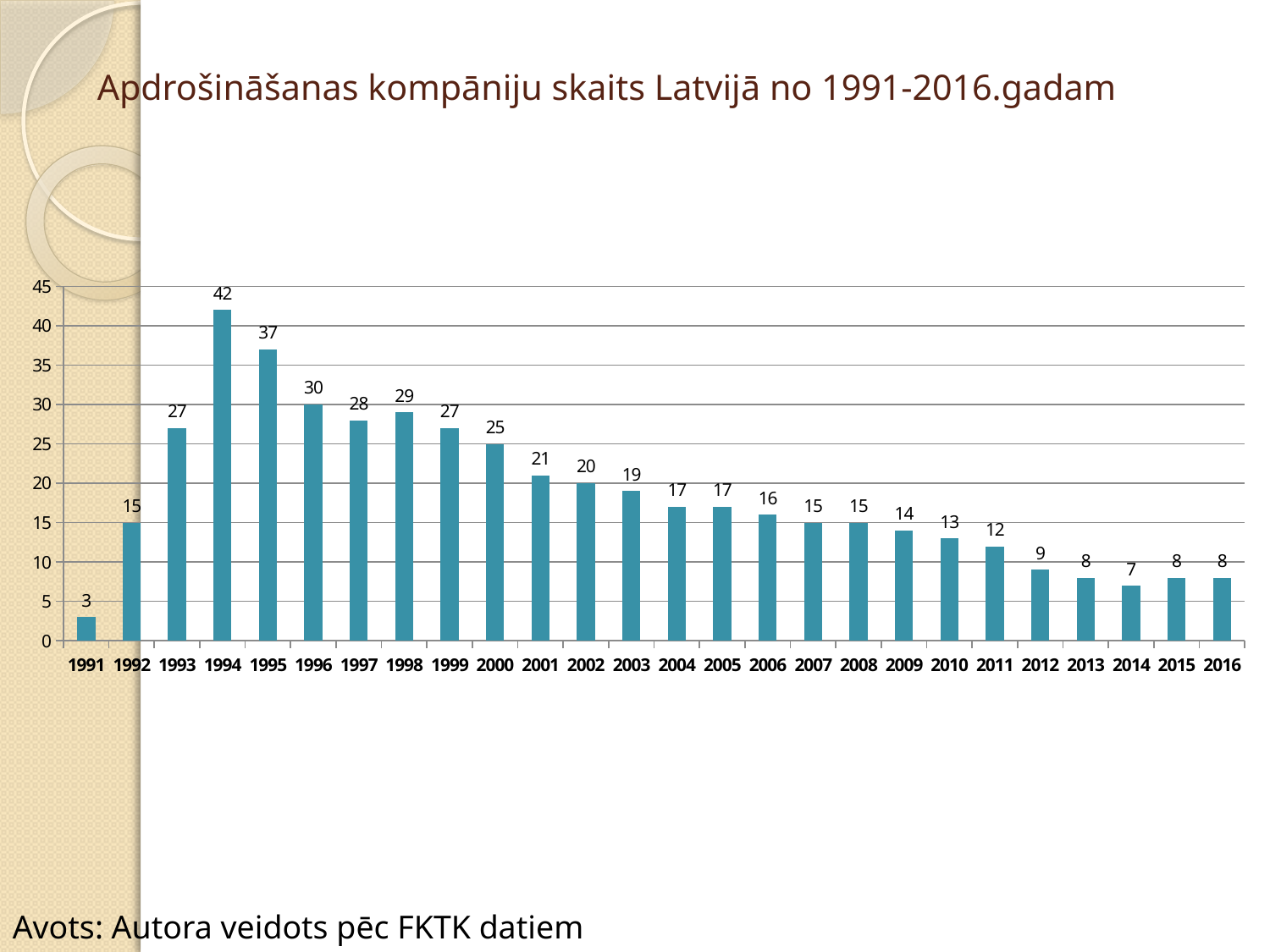
Which year has the lowest value? 1991 What is the difference between the values for 1994 and 1995? 5 What is the value for 1994? 42 What is the value for 2000? 25 What kind of chart is shown on the slide? bar chart How many years are shown on the x axis? 26 Do the values generally rise or fall from 1994 to 2014? fall What is the difference between the values for 1992 and 2016? 7 What is the title of the chart? Apdrošināšanas kompāniju skaits Latvijā no 1991-2016.gadam Which year has the highest value? 1994 What is the value for 2016? 8 Which is larger, the value for 1997 or the value for 1998? 1998